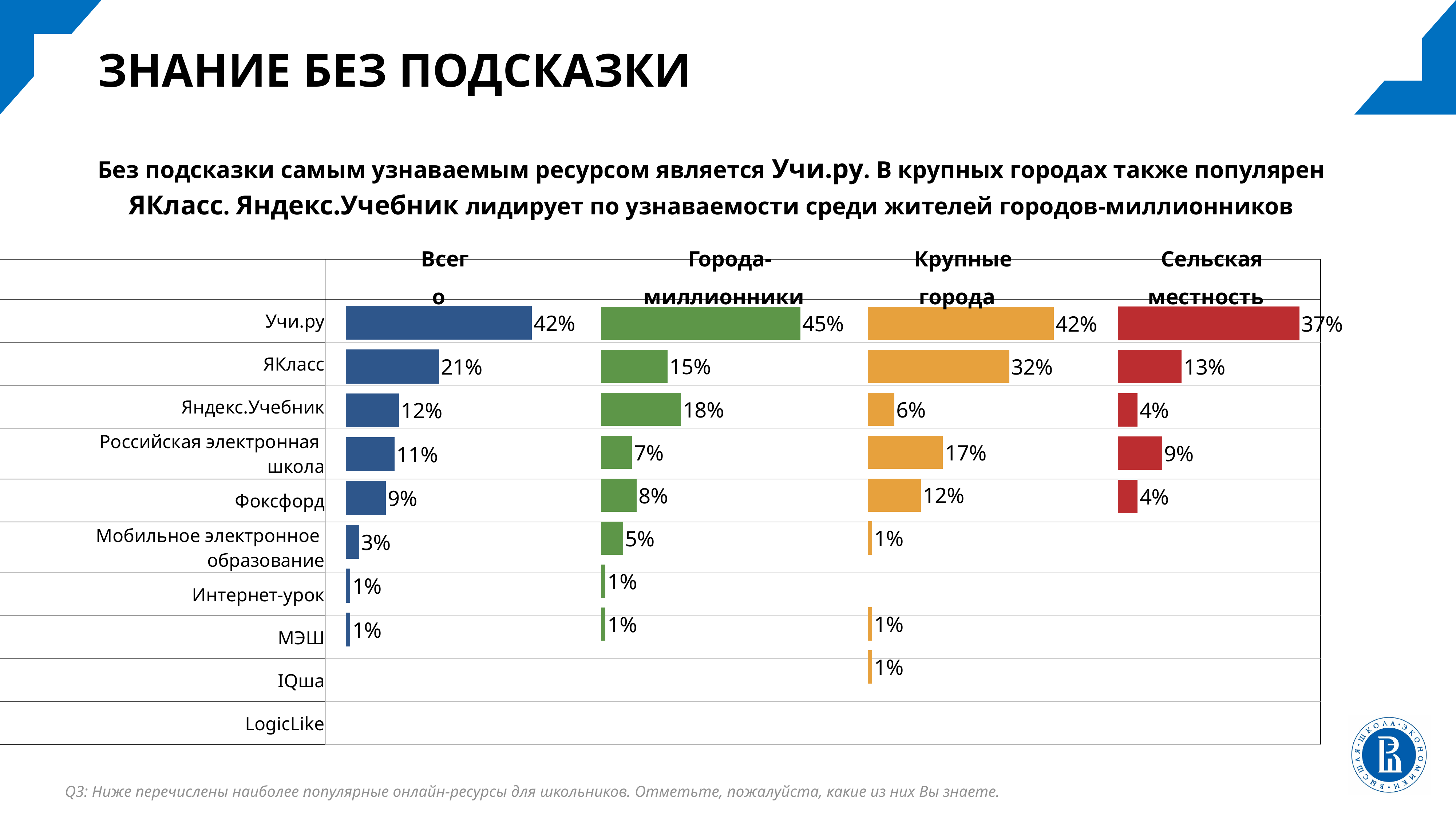
How many categories (resources) are listed on the chart's vertical axis? 10 How many series does the chart show? 4 What is the value for Российская электронная школа in the Сельская местность series? 9% Which is larger for Фоксфорд: the Всего value or the Крупные города value? Крупные города Which category has the highest value in the Сельская местность series? Учи.ру What kind of chart is shown on the slide? Bar chart What is the value for Яндекс.Учебник in the Города-миллионники series? 18% What is the value for ЯКласс in the Крупные города series? 32% Which category has the highest value in the Города-миллионники series? Учи.ру What is the difference between the Крупные города and Сельская местность values for ЯКласс? 19% What colour are the bars of the Крупные города series? Orange What is the value for Учи.ру in the Всего series? 42%